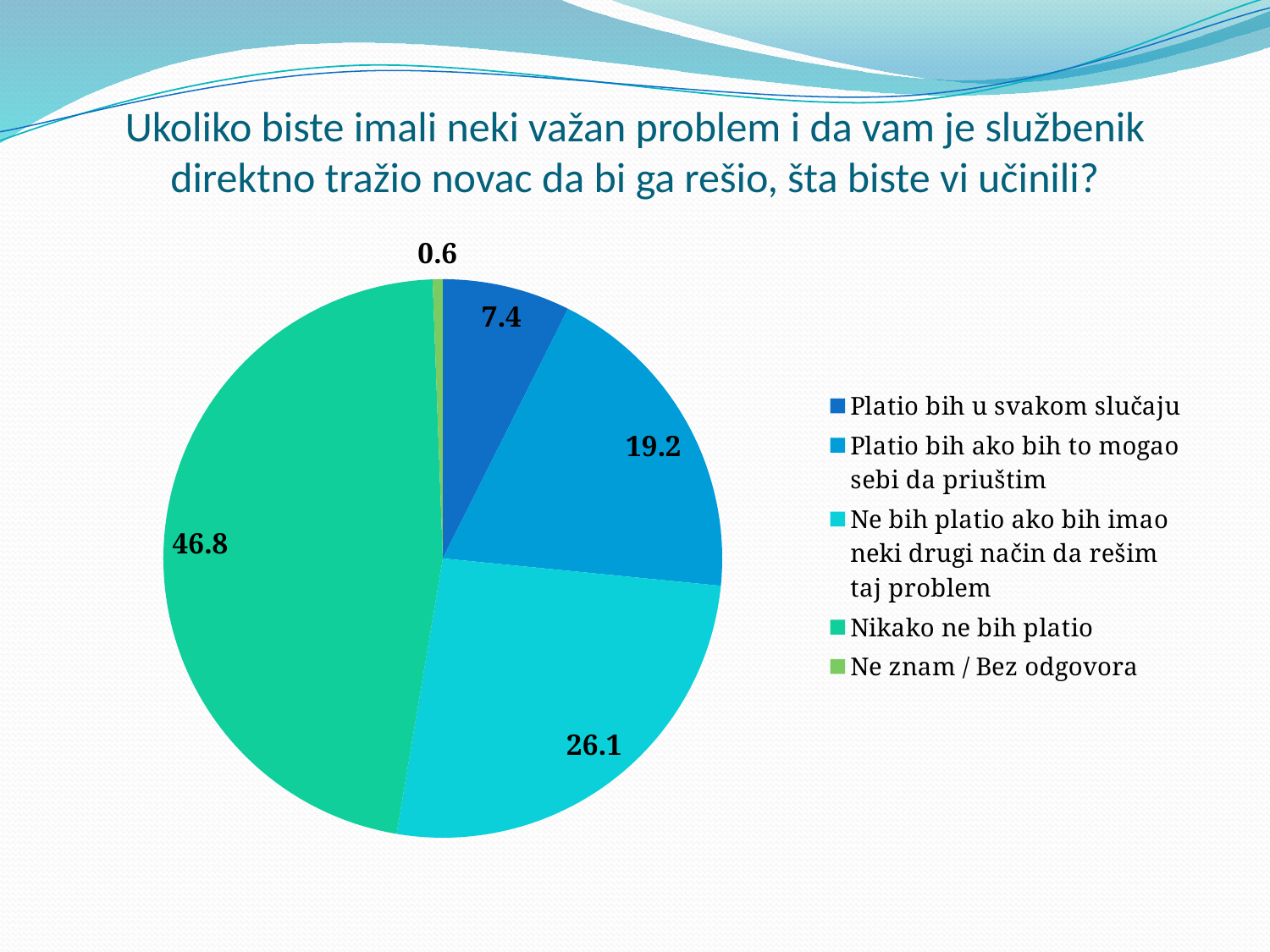
What is the difference between the values for "Nikako ne bih platio" and "Ne bih platio ako bih imao neki drugi način da rešim taj problem"? 20.7 What is the difference between the values for "Platio bih ako bih to mogao sebi da priuštim" and "Platio bih u svakom slučaju"? 11.8 What is the value for "Nikako ne bih platio"? 46.8 Which category has the largest slice? Nikako ne bih platio How many slices does the pie chart have? 5 Which category has the smallest slice? Ne znam / Bez odgovora Which is larger: "Platio bih ako bih to mogao sebi da priuštim" or "Platio bih u svakom slučaju"? Platio bih ako bih to mogao sebi da priuštim What kind of chart is shown on the slide? pie chart What is the value for "Ne znam / Bez odgovora"? 0.6 How many entries does the legend list? 5 What is the value for "Platio bih u svakom slučaju"? 7.4 What is the value for "Platio bih ako bih to mogao sebi da priuštim"? 19.2